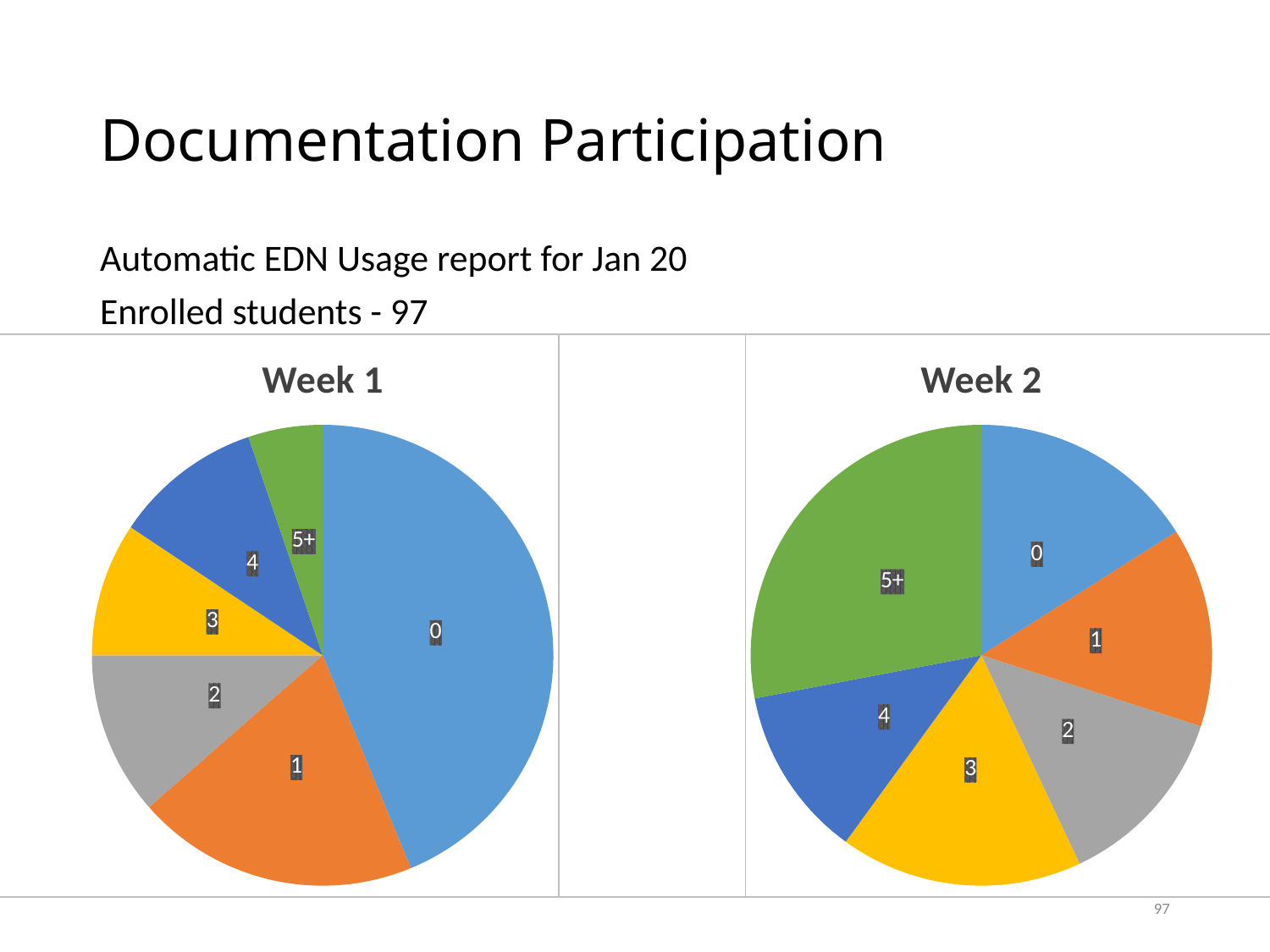
What is the title of the chart on the left side of the slide? Week 1 In the Week 2 chart, which category has the largest slice? 5+ In the Week 1 chart, which category has the smallest slice? 5+ How many slices does the Week 2 pie chart have? 6 In the Week 2 chart, which slice is larger, 5+ or 0? 5+ In the Week 2 chart, what colour is the 5+ slice? green What kind of chart is the Week 2 chart? pie chart How many slices does the Week 1 pie chart have? 6 In the Week 1 chart, which slice is larger, 1 or 2? 1 In the Week 1 chart, which category has the largest slice? 0 What kind of chart is the Week 1 chart? pie chart In the Week 1 chart, which slice is larger, 0 or 1? 0